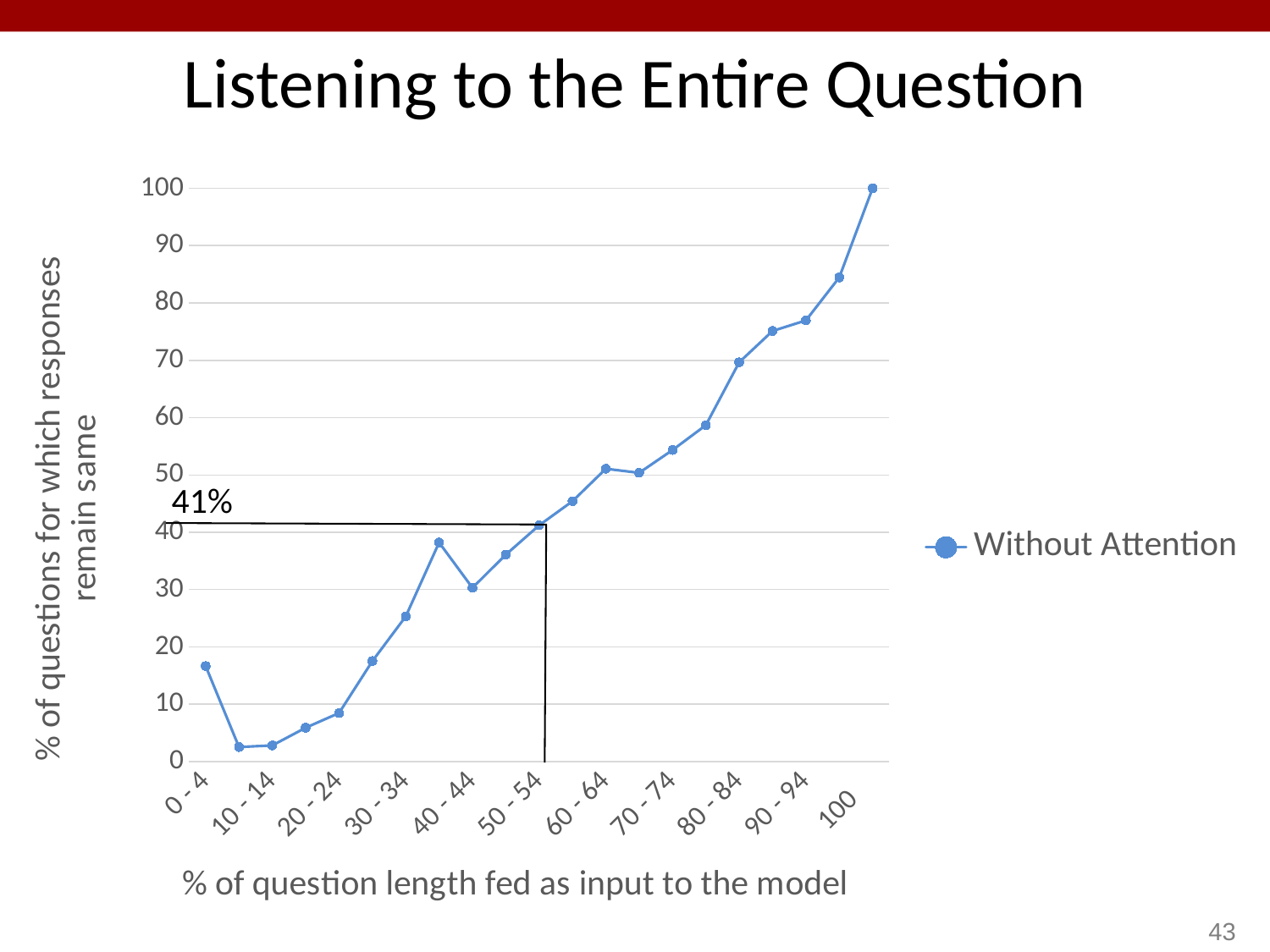
What kind of chart is shown on the slide? line chart What is the value for the 50 - 54 category, as annotated on the chart? 41% Which category has the highest value? 100 What is the value for the 100 category? 100 Is the value for 0 - 4 greater or less than 20? less Do the values generally rise or fall as the % of question length increases along the x axis? rise Is the value for 80 - 84 greater or less than 60? greater How many series does the legend list? 1 Is the value for 20 - 24 greater or less than 10? less What is the name of the series shown in the legend? Without Attention Which has the larger value, 30 - 34 or 40 - 44? 40 - 44